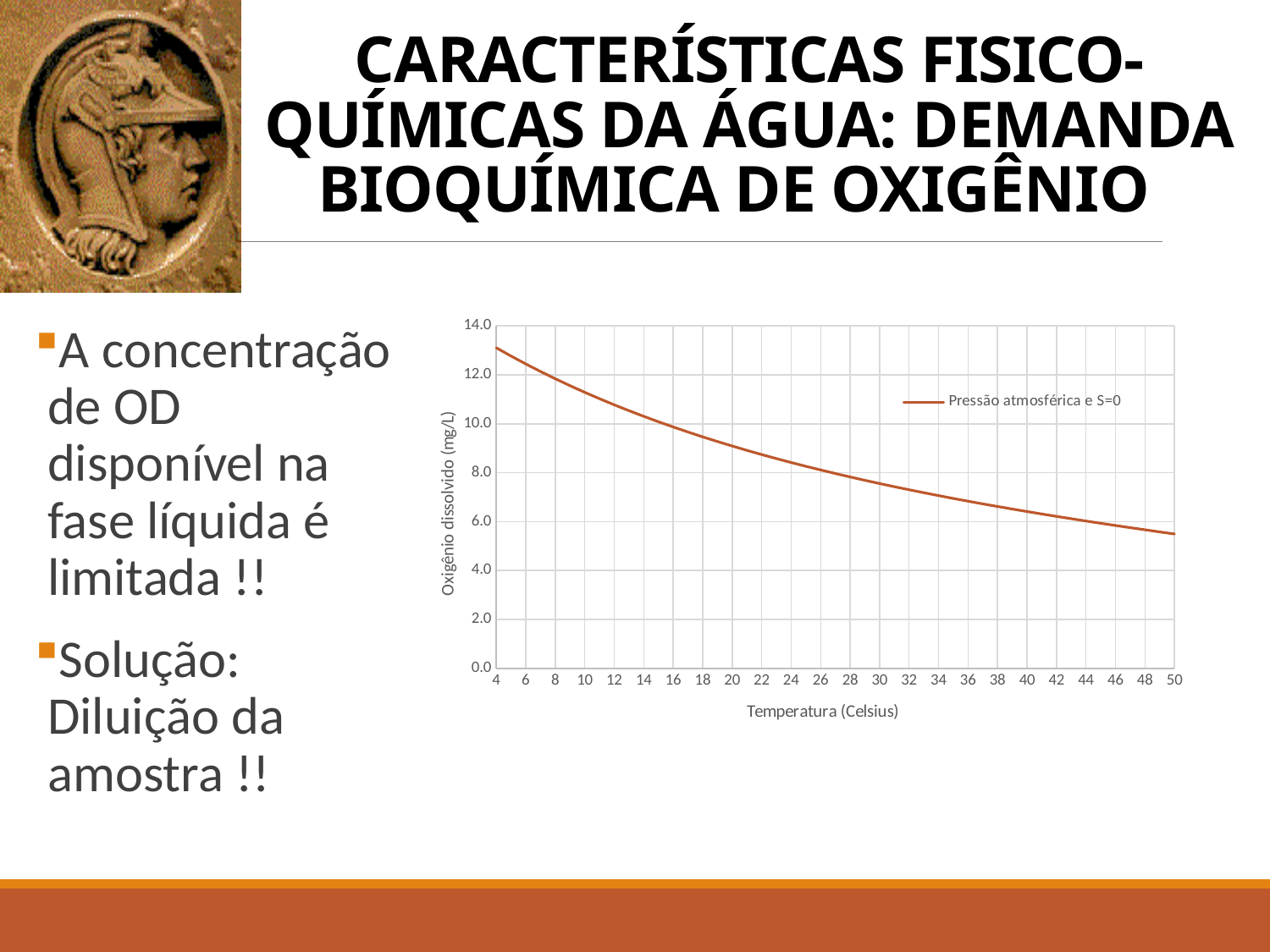
How many series does the chart legend list? 1 Is the dissolved oxygen value at 4 °C greater or less than 12.0? greater Does dissolved oxygen rise or fall as temperature increases along the x axis? fall Which is larger, the dissolved oxygen value at 10 °C or at 40 °C? 10 °C Is the dissolved oxygen value at 30 °C greater or less than 8.0? less At which temperature on the x axis is the dissolved oxygen value highest? 4 Is the dissolved oxygen value at 20 °C greater or less than 8.0? greater What kind of chart is shown on the slide? line chart What is the name of the series shown in the chart legend? Pressão atmosférica e S=0 What is the title of the x axis of the chart? Temperatura (Celsius) At which temperature on the x axis is the dissolved oxygen value lowest? 50